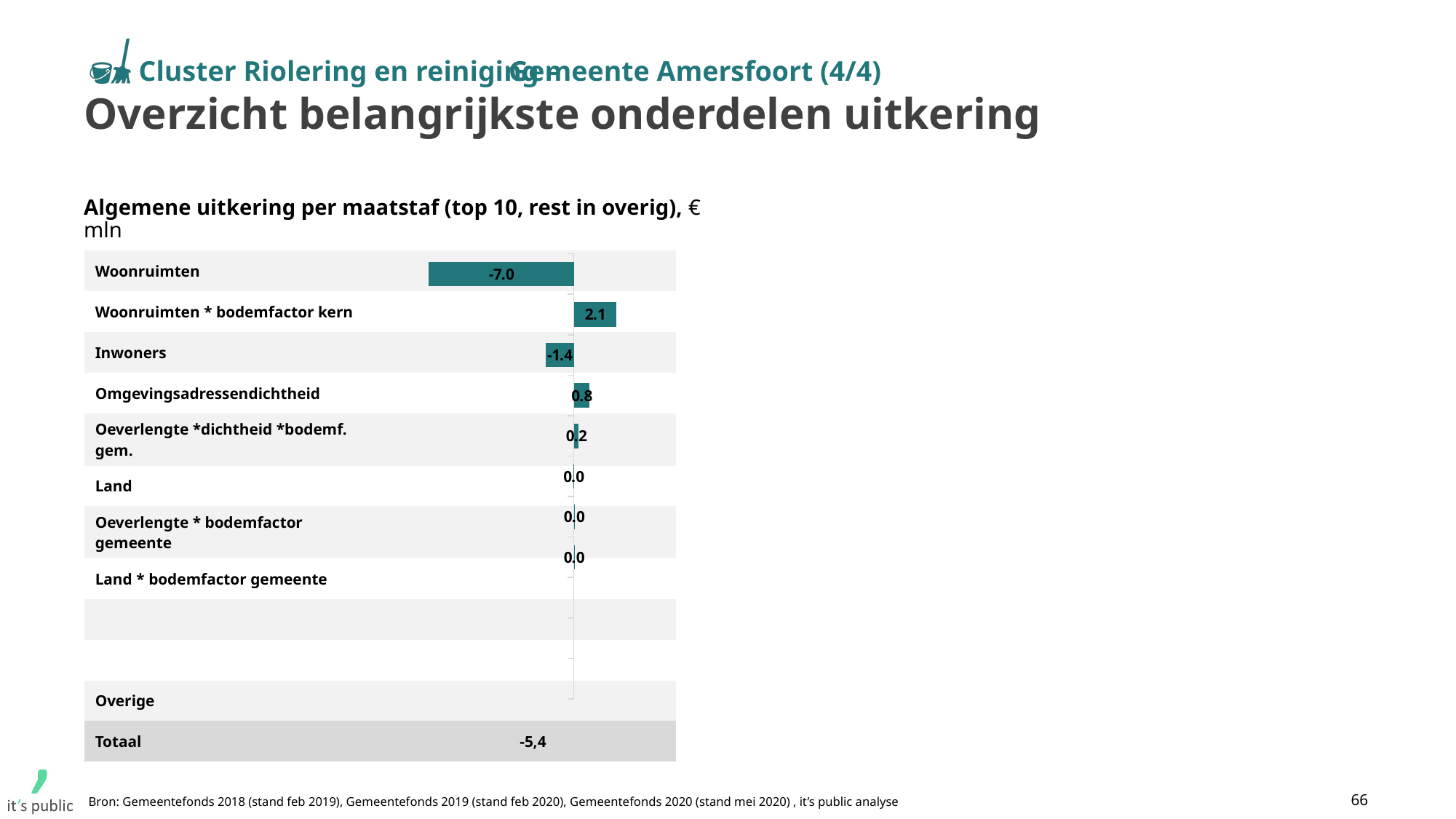
What is the value for Land? 0.0 What is the value for Woonruimten * bodemfactor kern? 2.1 What unit is stated in the chart title? € mln What kind of chart is shown on the slide? Bar chart What is the Totaal value shown at the bottom of the chart? -5,4 Which category has the highest value? Woonruimten * bodemfactor kern What is the difference between the values for Woonruimten * bodemfactor kern and Inwoners? 3.5 What is the value for Inwoners? -1.4 What is the value for Woonruimten? -7.0 What is the value for Omgevingsadressendichtheid? 0.8 Which category has the lowest (most negative) value? Woonruimten Which is larger, the value for Omgevingsadressendichtheid or the value for Oeverlengte *dichtheid *bodemf. gem.? Omgevingsadressendichtheid